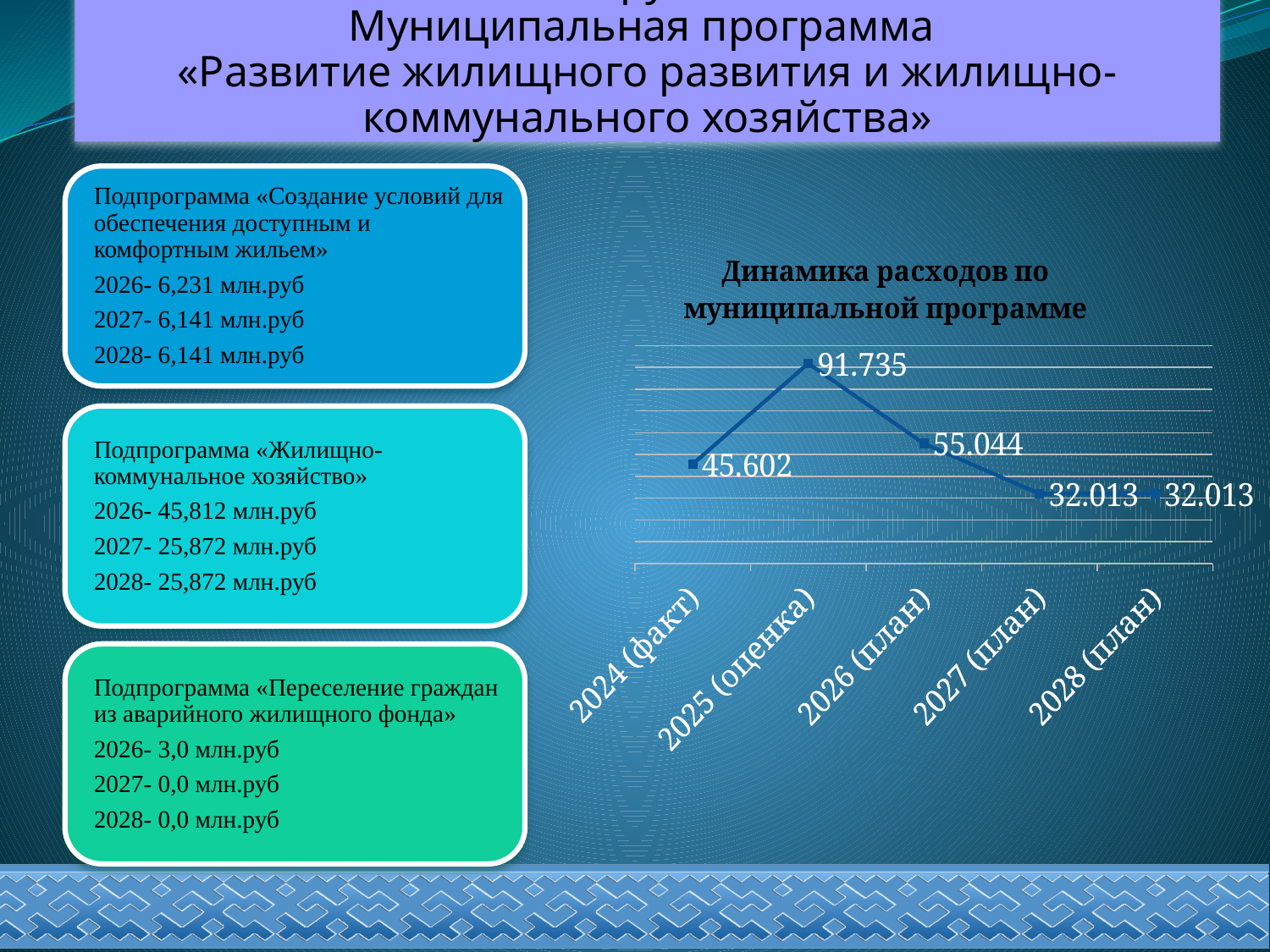
What is the value for 2026 (план)? 55.044 What is the value for 2025 (оценка)? 91.735 What is the value for 2028 (план)? 32.013 Do the values rise or fall from 2025 (оценка) to 2027 (план)? fall Which is larger, the value for 2024 (факт) or the value for 2026 (план)? 2026 (план) What is the title of the chart on the slide? Динамика расходов по муниципальной программе Which category has the highest value on the chart? 2025 (оценка) What is the value for 2024 (факт)? 45.602 What kind of chart is shown on the slide? line chart How many data points are plotted on the chart? 5 What is the difference between the values for 2025 (оценка) and 2026 (план)? 36.691 What is the difference between the values for 2024 (факт) and 2027 (план)? 13.589